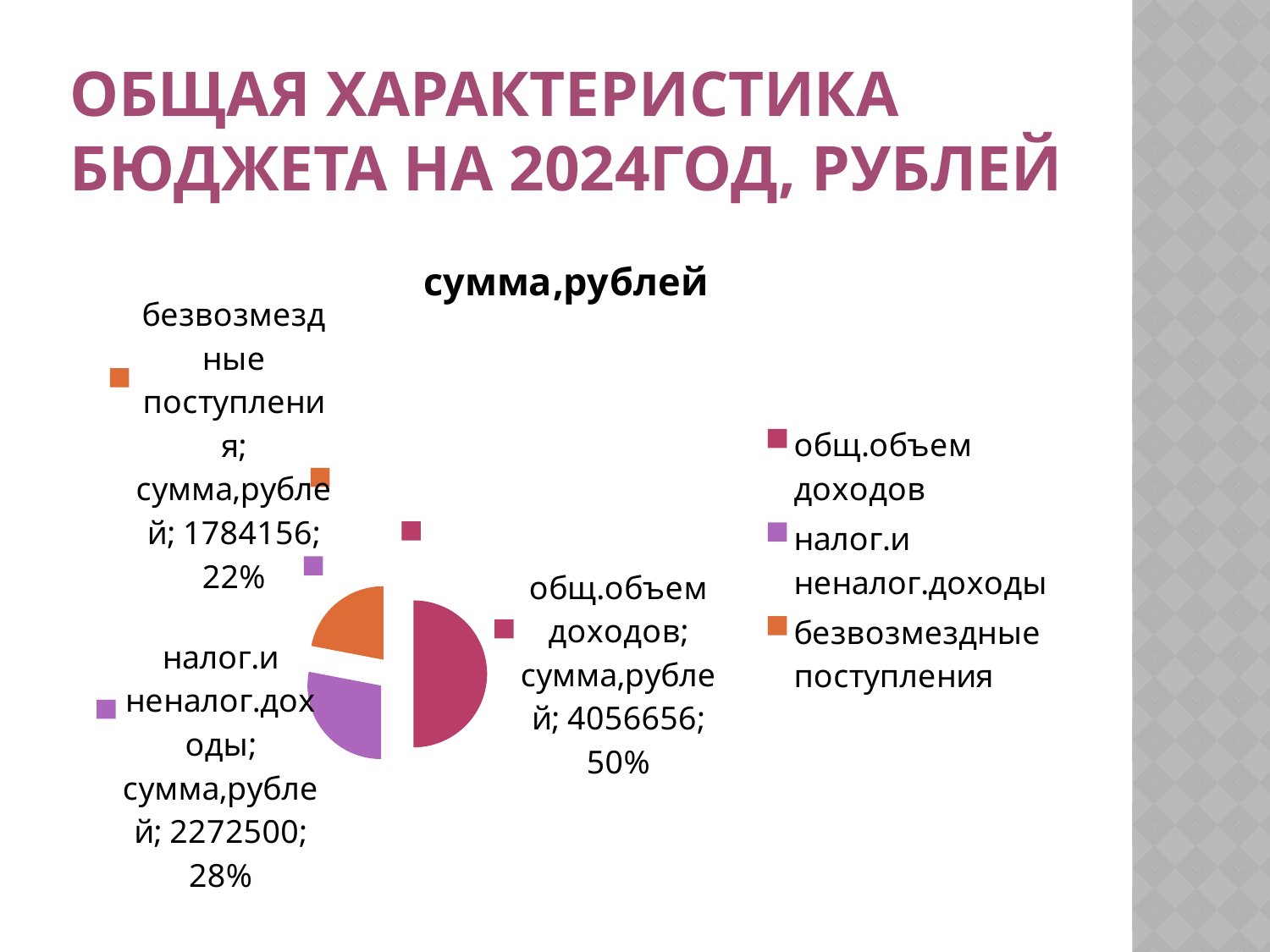
How many slices does the pie chart have? 3 What share of the pie does безвозмездные поступления take? 22% Which category has the largest slice? общ.объем доходов What is the value for налог.и неналог.доходы? 2272500 Which category has the smallest slice? безвозмездные поступления What is the value for безвозмездные поступления? 1784156 What is the value for общ.объем доходов? 4056656 What share of the pie does общ.объем доходов take? 50% What is the title of the chart? сумма,рублей Which is larger, the value for налог.и неналог.доходы or the value for безвозмездные поступления? налог.и неналог.доходы What kind of chart is shown on the slide? pie chart What is the difference between the values for налог.и неналог.доходы and безвозмездные поступления? 488344